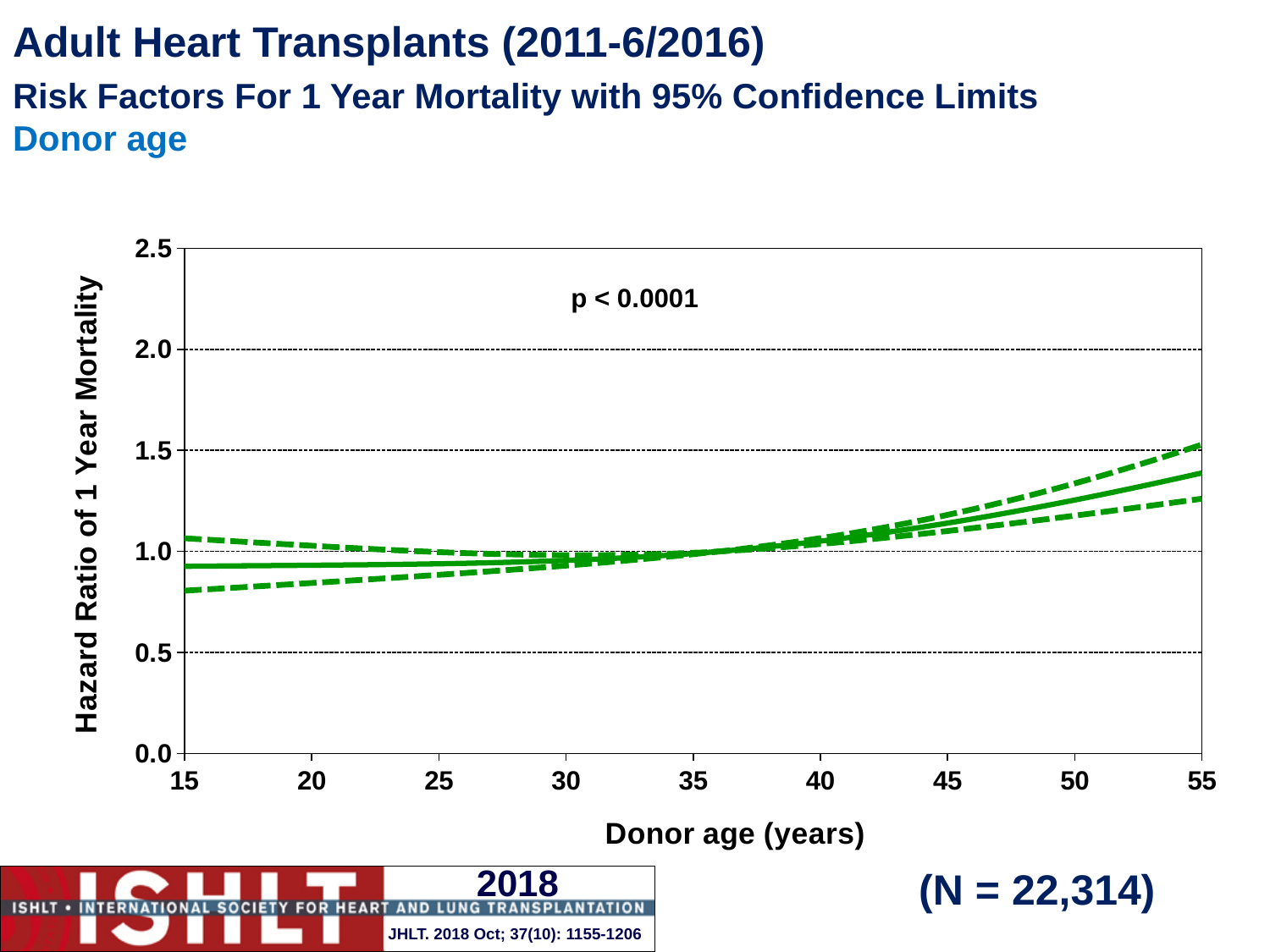
Is the lower 95% confidence limit at a donor age of 15 years greater or less than 0.5? greater Is the hazard ratio of 1 year mortality higher at a donor age of 55 years or at a donor age of 15 years? 55 years Is the hazard ratio of 1 year mortality at a donor age of 15 years greater or less than 1.0? less Is the hazard ratio of 1 year mortality at a donor age of 45 years greater or less than 1.0? greater What sample size (N) is shown on the slide? N = 22,314 What p-value is printed on the chart? p < 0.0001 What kind of chart is shown on the slide? line chart How many labeled tick marks are there on the donor age (x) axis? 9 At which donor age shown on the x axis is the hazard ratio of 1 year mortality highest? 55 Does the hazard ratio of 1 year mortality rise or fall as donor age increases from 35 to 55 years? rise